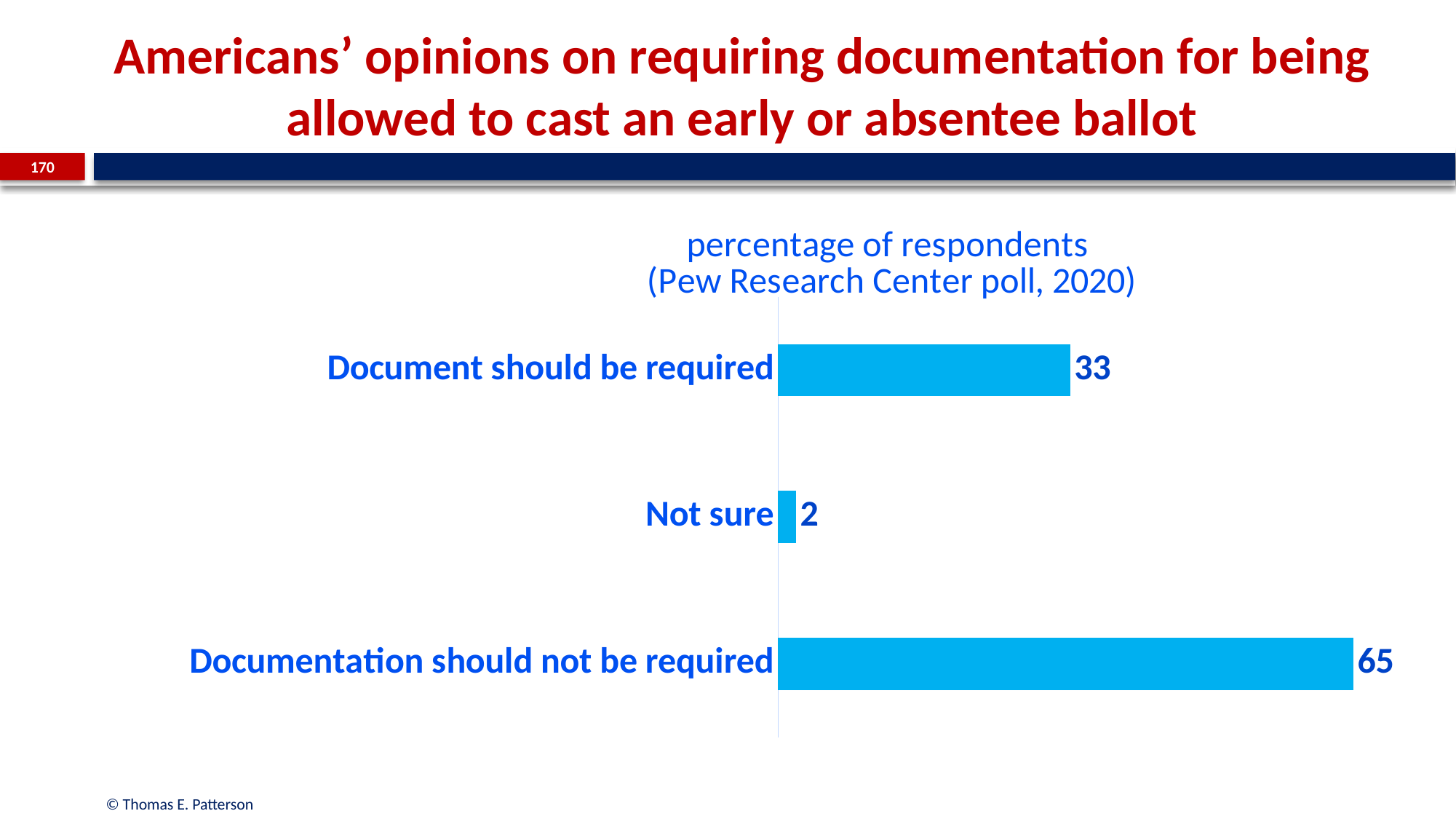
What kind of chart is shown on the slide? Bar chart What percentage of respondents said a document should be required? 33 What is the total of the three values shown in the chart? 100 According to the chart title, which organization conducted the poll and in what year? Pew Research Center, 2020 Which is larger: the value for 'Document should be required' or the value for 'Documentation should not be required'? Documentation should not be required How many categories are shown in the chart? 3 Which category has the highest value? Documentation should not be required What percentage of respondents said documentation should not be required? 65 What is the difference between the values for 'Document should be required' and 'Not sure'? 31 What is the difference between the values for 'Documentation should not be required' and 'Document should be required'? 32 What percentage of respondents were not sure? 2 Which category has the lowest value? Not sure